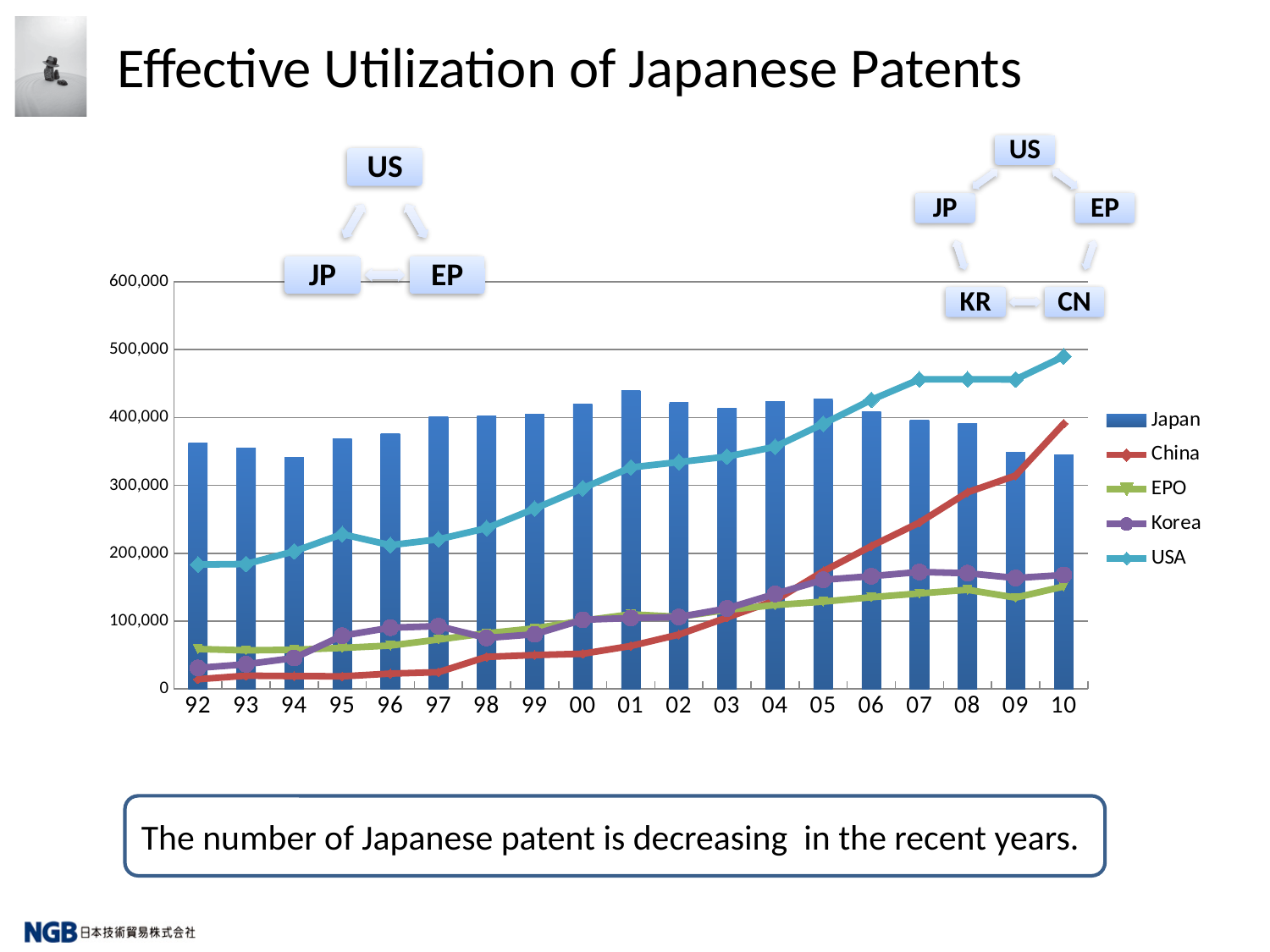
How many years are shown along the x axis of the chart? 19 Is the value for Japan in 01 greater or less than 400,000? greater What kind of chart is shown on the slide? A combined bar and line chart In 10, which is larger, the value for USA or the value for Japan? USA Is the value for USA in 92 greater or less than 200,000? less Is the value for USA in 10 greater or less than 400,000? greater In 92, which is larger, the value for Japan or the value for USA? Japan How many series does the chart legend list? 5 Which series is plotted as bars rather than a line? Japan In which year is the Japan bar the highest? 01 Does the USA line rise or fall overall from 92 to 10? rise